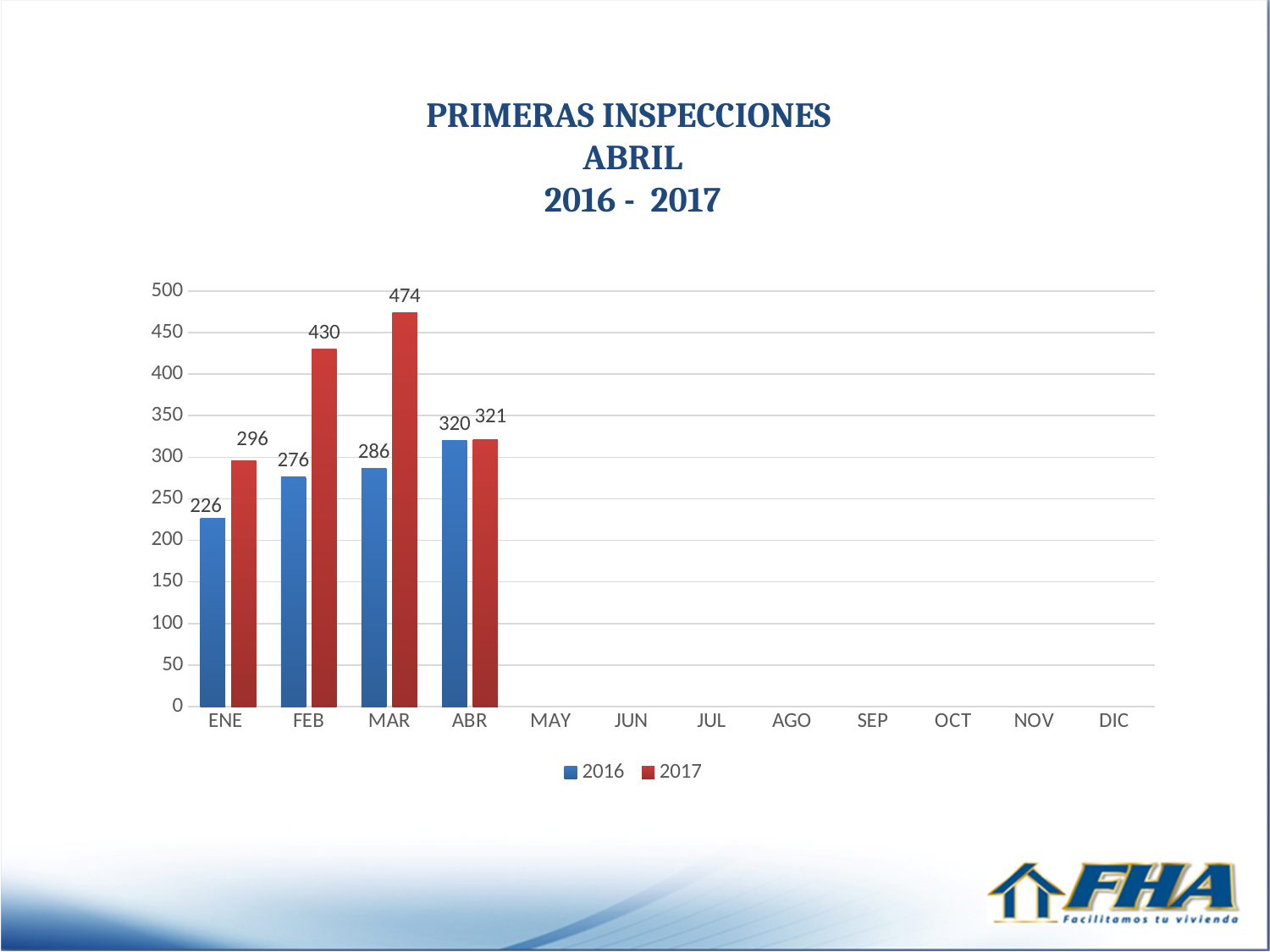
What is the value for 2017 in MAR? 474 What is the value for 2016 in ENE? 226 What is the difference between the 2017 and 2016 values in MAR? 188 Do the 2016 values rise or fall from ENE to ABR? Rise Which month has the highest value for the 2017 series? MAR What kind of chart is shown on the slide? Bar chart Which is larger in FEB, the 2016 value or the 2017 value? 2017 How many months have plotted bars in the chart? 4 Which month has the lowest value for the 2016 series? ENE What is the value for 2017 in FEB? 430 What is the value for 2016 in ABR? 320 How many series does the legend list? 2